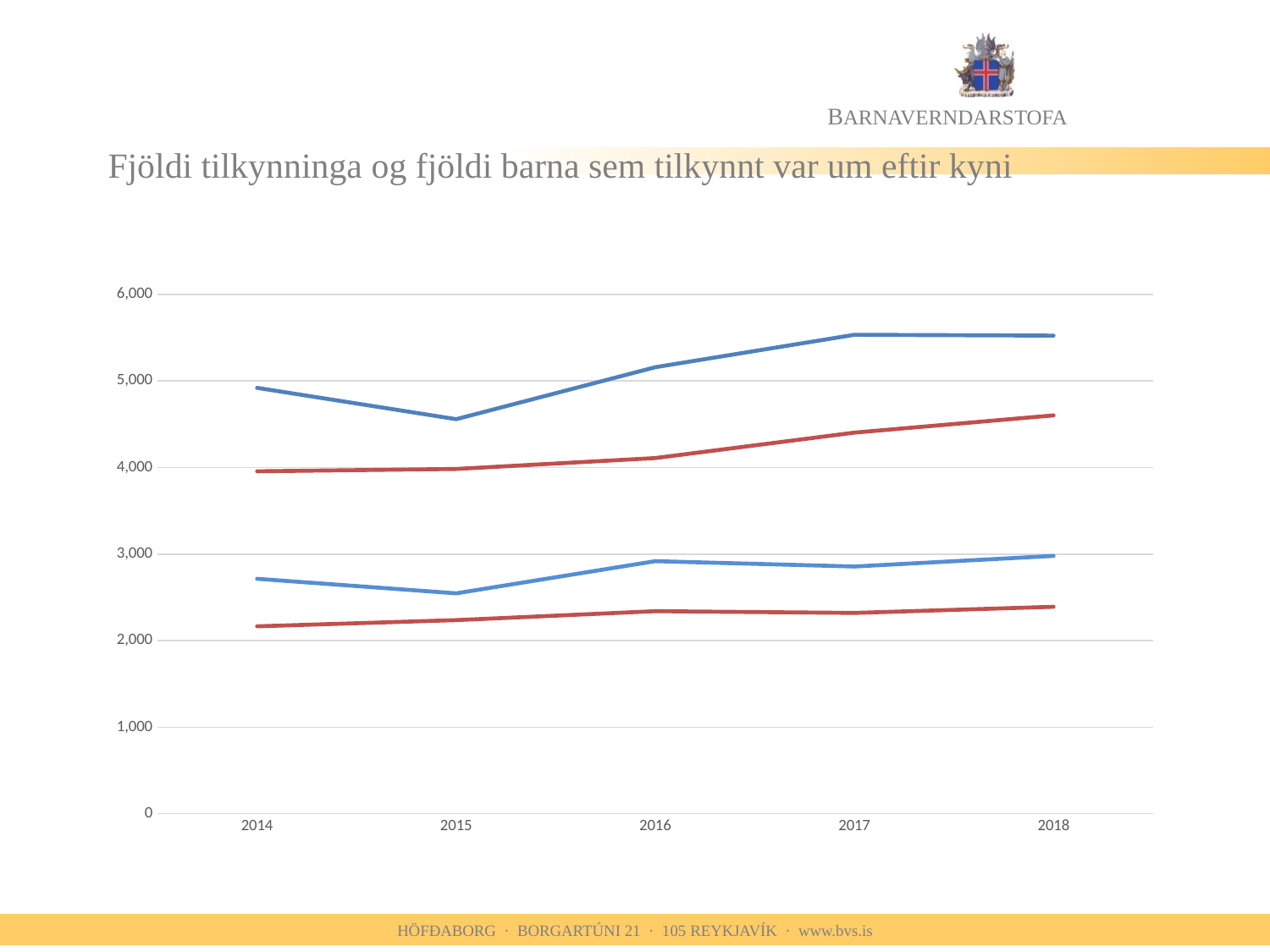
What is the title of the chart on the slide? Fjöldi tilkynninga og fjöldi barna sem tilkynnt var um eftir kyni Is the value of the lower light blue line in 2015 greater or less than 3,000? less In which year is the topmost dark blue line at its lowest value? 2015 In 2018, which is larger: the topmost dark blue line or the upper red line? The topmost dark blue line Is the value of the lowest red line in 2018 greater or less than 3,000? less Is the value of the topmost dark blue line in 2015 greater or less than 5,000? less Does the upper red line rise or fall from 2014 to 2018? Rises How many lines are plotted on the chart? 4 What kind of chart is shown on the slide? Line chart How many years are shown on the x axis of the chart? 5